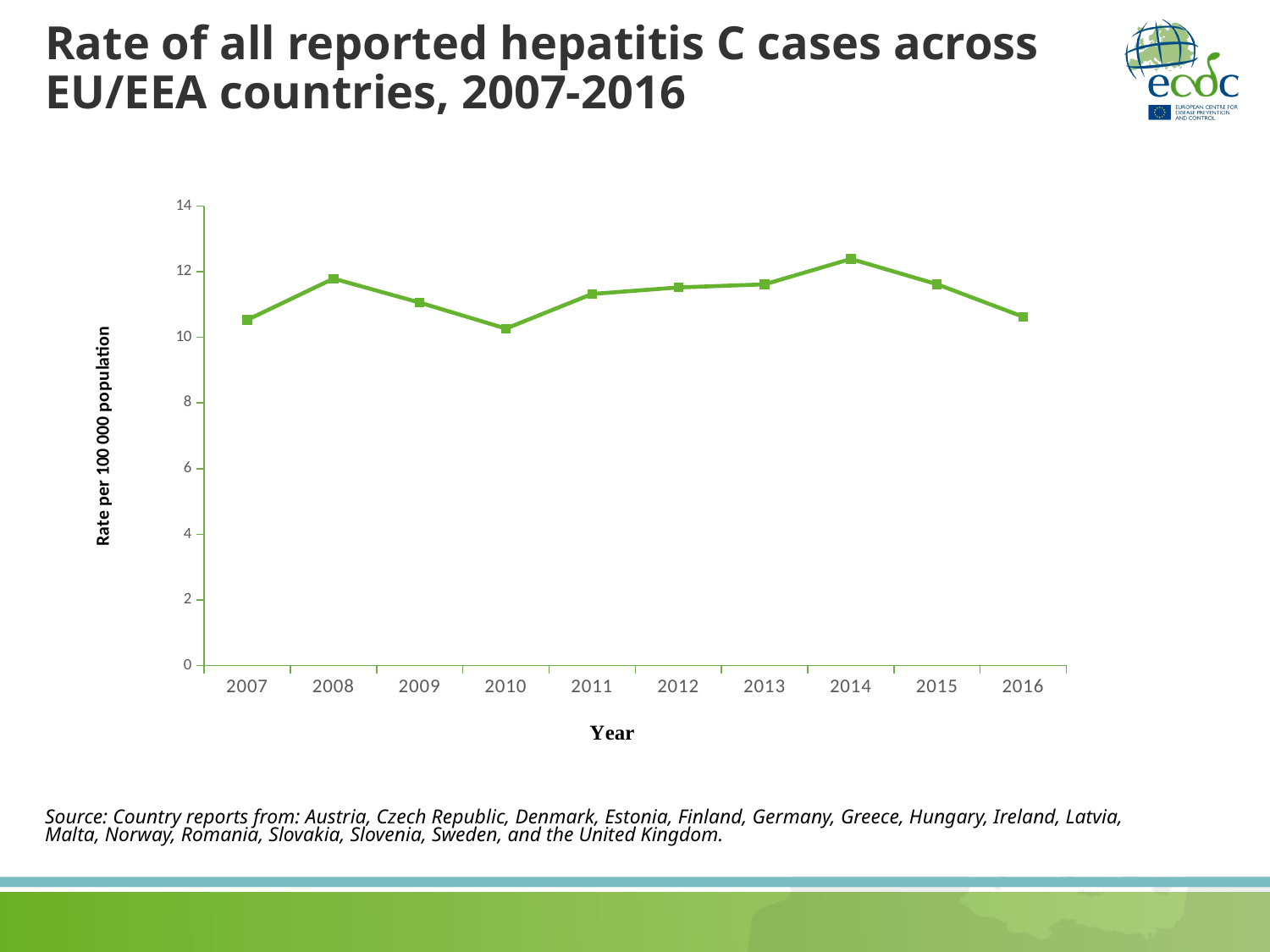
What kind of chart is shown on the slide? line chart Is the value for 2007 greater or less than 10? greater Is the value for 2016 greater or less than 12? less How many years are plotted on the x axis? 10 Which year has the higher rate, 2014 or 2007? 2014 What is the label on the y axis of the chart? Rate per 100 000 population Is the value for 2014 greater or less than 12? greater Does the rate rise or fall from 2010 to 2014? rise Which year has the higher rate, 2008 or 2010? 2008 Does the rate rise or fall from 2014 to 2016? fall Which year has the highest rate of reported hepatitis C cases? 2014